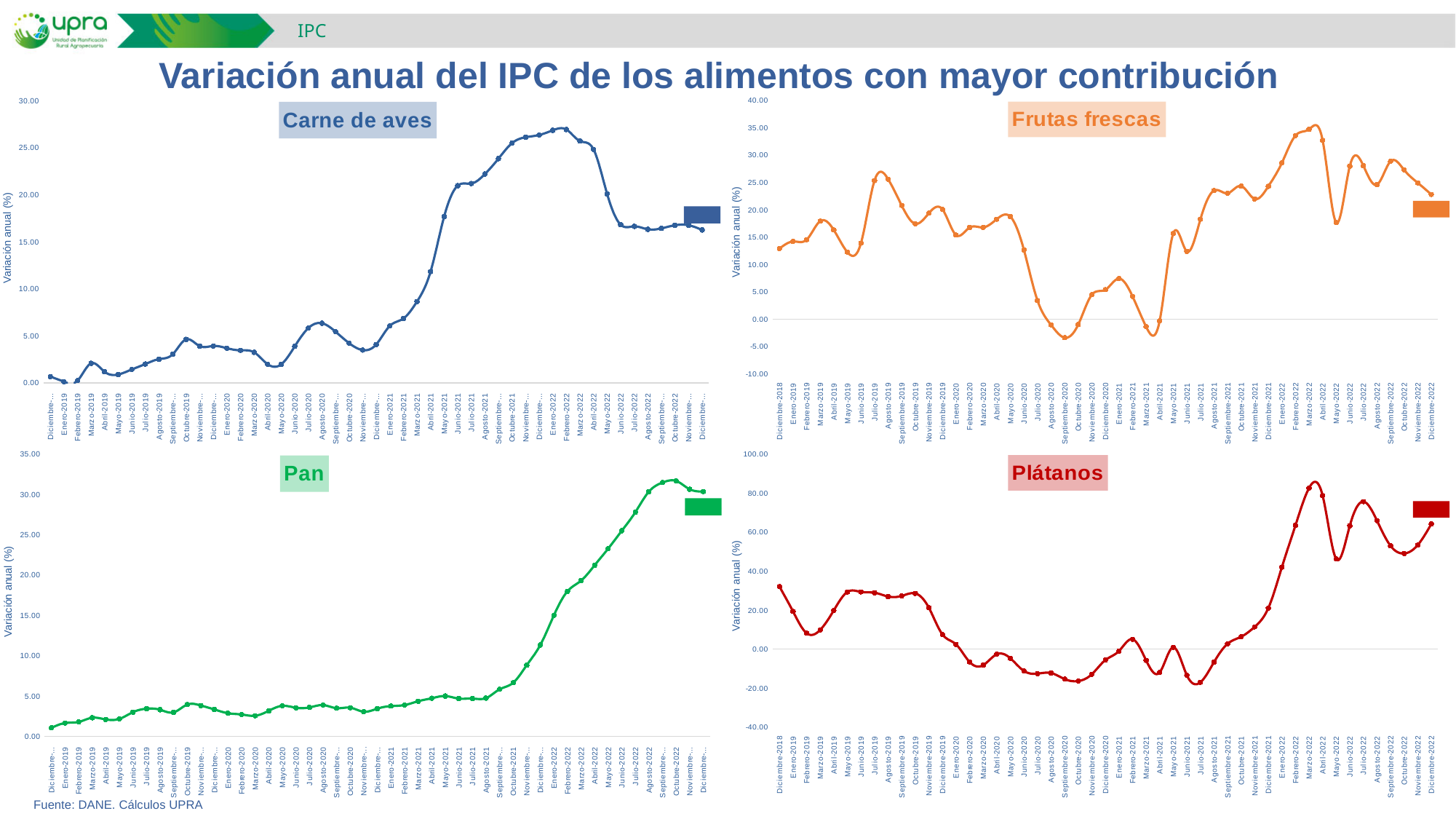
How many charts are shown on the slide? 4 In the 'Pan' chart, do the values overall rise or fall from Diciembre-2018 to Diciembre-2022? rise In the 'Carne de aves' chart, is the value for Febrero-2022 greater or less than 25.00? greater In the 'Frutas frescas' chart, is the value for Marzo-2022 greater or less than 30.00? greater In the 'Plátanos' chart, is the value for Marzo-2022 greater or less than 60.00? greater What kind of chart is the 'Carne de aves' chart? line chart What is the main title of the slide above the four charts? Variación anual del IPC de los alimentos con mayor contribución